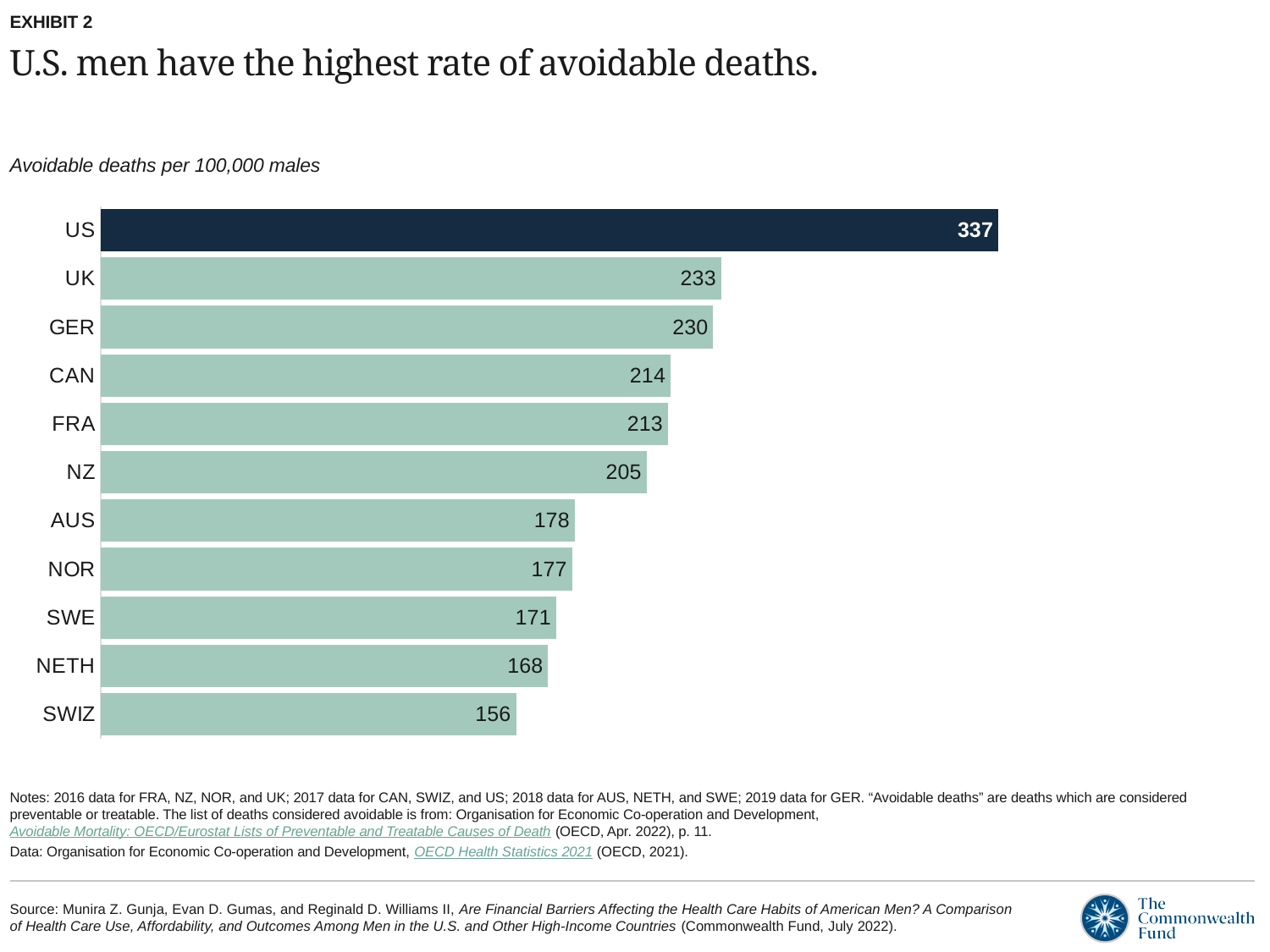
What is the rate of avoidable deaths per 100,000 males for the US? 337 What is the value shown for GER? 230 What is the value shown for SWE? 171 Which country has the lowest rate of avoidable deaths per 100,000 males? SWIZ What is the difference between the US value and the UK value? 104 Which has a higher value, AUS or SWE? AUS What kind of chart is shown on the slide? Bar chart What is the difference between the values for NETH and SWIZ? 12 Which country has the highest rate of avoidable deaths per 100,000 males? US How many countries are shown in the chart? 11 Which has a higher value, CAN or NZ? CAN Which bar is shown in a different, darker colour from the others? US